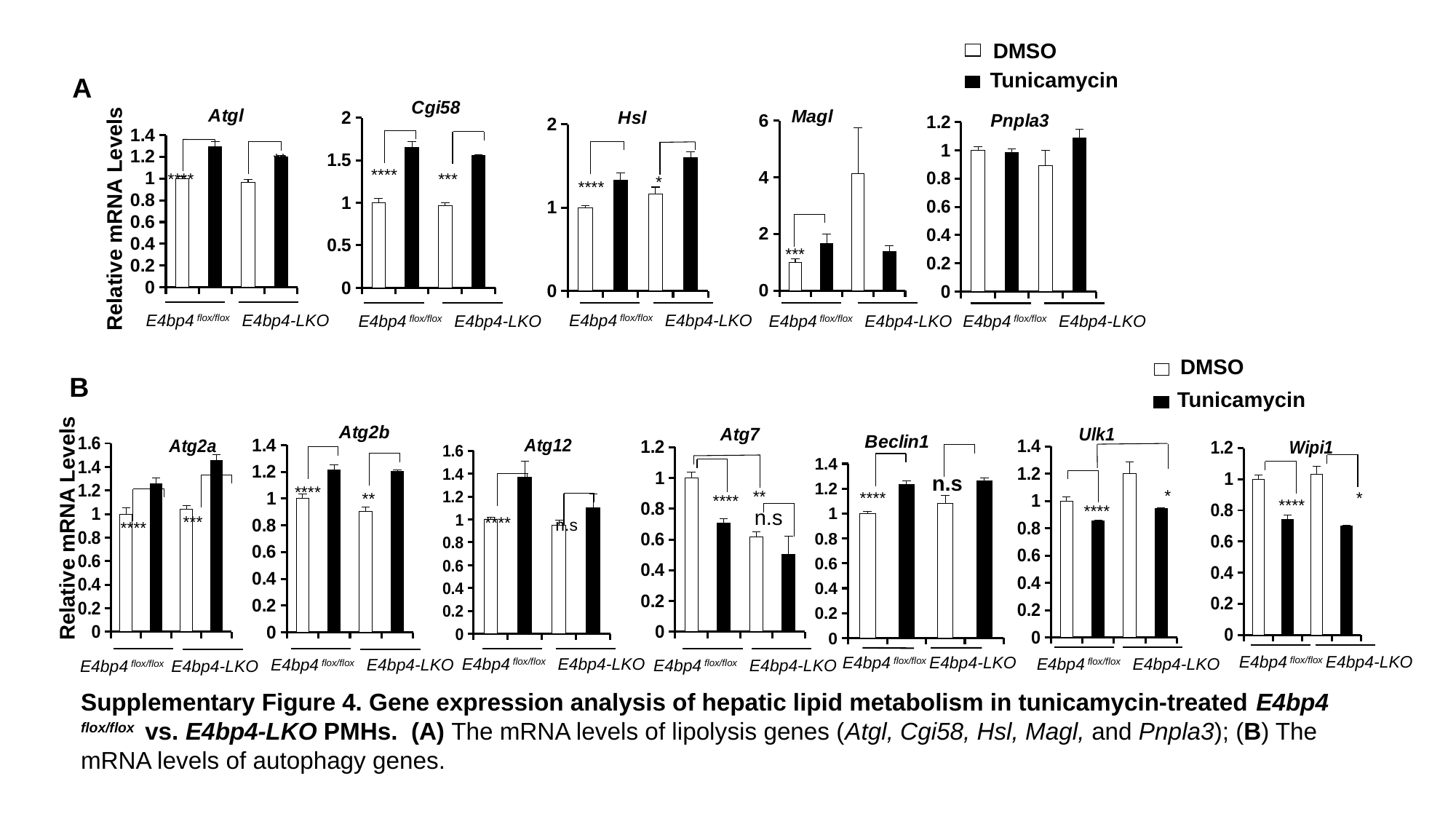
In the Magl chart, is the DMSO value for E4bp4-LKO greater or less than 2? greater In the Atg7 chart, is the Tunicamycin value for E4bp4-LKO greater or less than 0.8? less In the Atg7 chart, which is larger for E4bp4 flox/flox: the DMSO bar or the Tunicamycin bar? DMSO In the Magl chart, is the Tunicamycin value for E4bp4 flox/flox greater or less than 2? less How many gene charts are shown in section A? 5 How many series does the legend in section A list? 2 What kind of chart is used for the Atgl panel in section A? bar chart How many gene charts are shown in section B? 7 In the Cgi58 chart, which is larger for E4bp4 flox/flox: the DMSO bar or the Tunicamycin bar? Tunicamycin What is the y-axis label shared by the charts in section A? Relative mRNA Levels In the Magl chart, which group has the highest DMSO bar? E4bp4-LKO